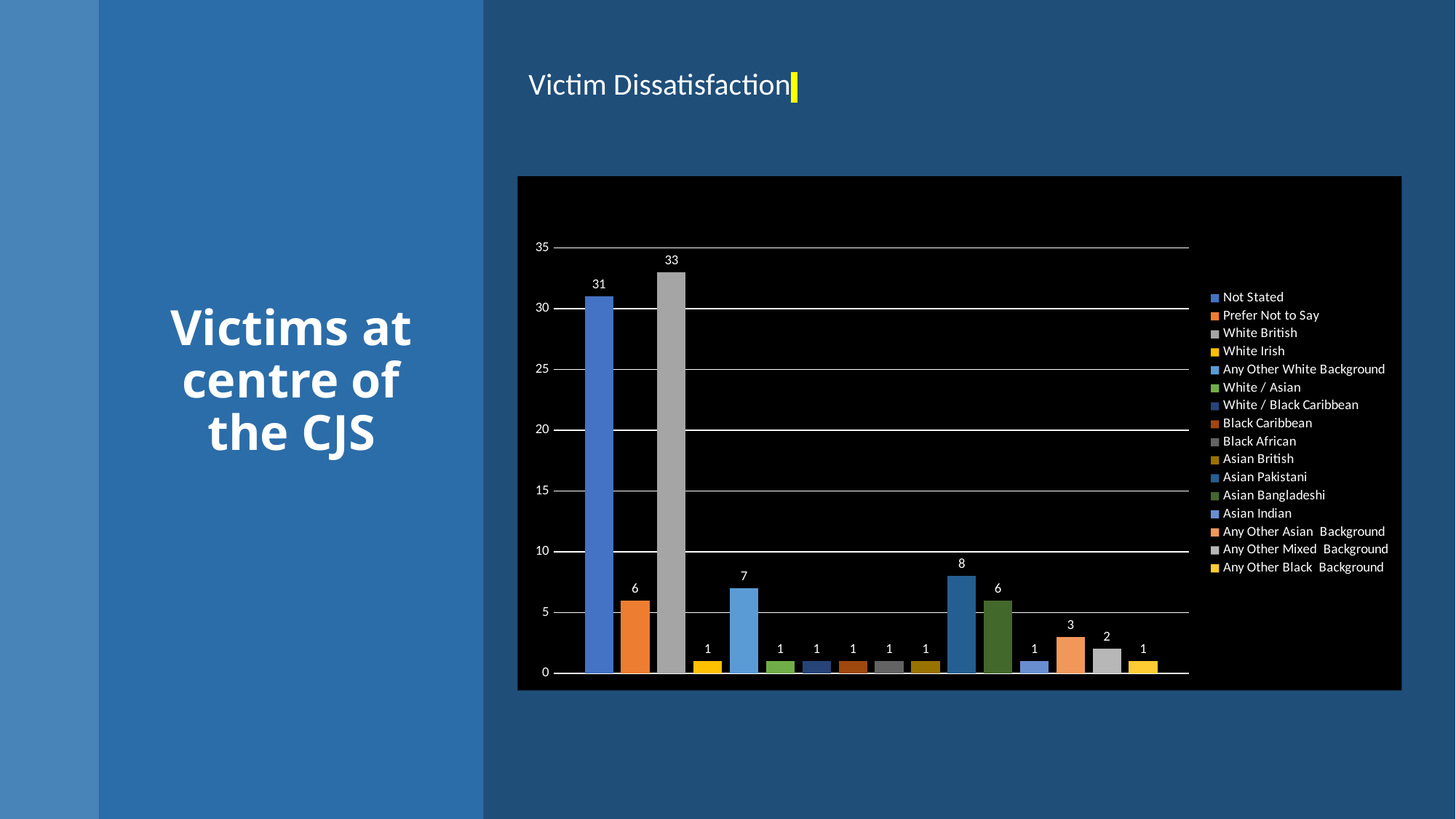
What is the value for Any Other White Background? 7 What is the difference between the values for White British and Not Stated? 2 What is the value for Not Stated? 31 What type of chart is shown on the slide? bar chart Is the value for Not Stated greater or less than 30? greater What is the value for White British? 33 What is the value for Any Other Asian Background? 3 How many entries does the legend list? 16 What is the title of the chart? Victim Dissatisfaction What is the value for Asian Pakistani? 8 Which category has the highest value? White British Which is larger, the value for Asian Pakistani or the value for Asian Bangladeshi? Asian Pakistani